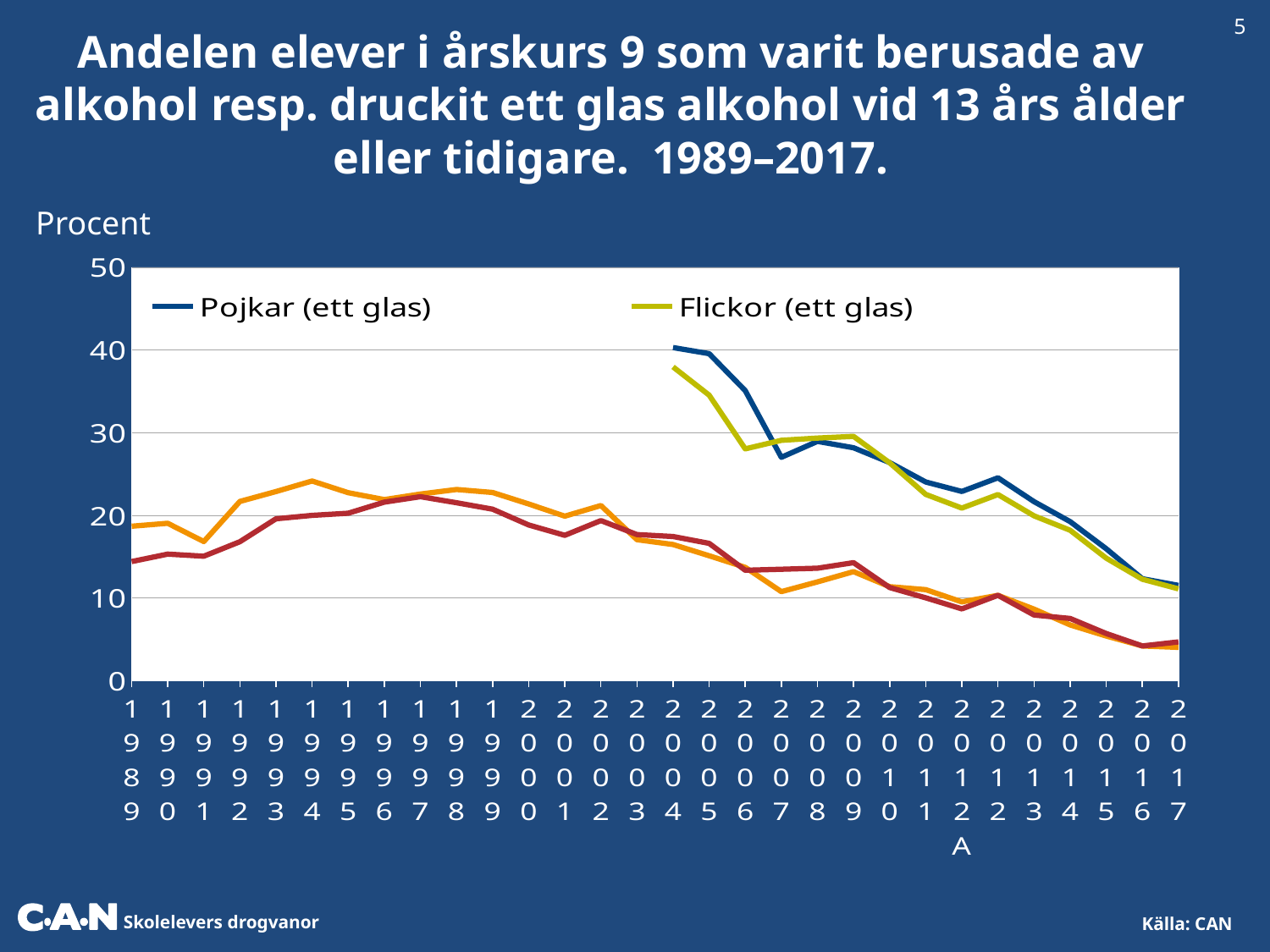
What kind of chart is shown on the slide? line chart What label is shown above the y axis of the chart? Procent Is the value for Pojkar (ett glas) in 2017 greater or less than 20? less Does the Pojkar (ett glas) series generally rise or fall from 2004 to 2017? fall Is the value for Flickor (ett glas) in 2006 greater or less than 30? less Is the value for Pojkar (ett glas) in 2012 greater or less than 20? greater Which two series are named in the chart's legend? Pojkar (ett glas) and Flickor (ett glas) In which year does the Pojkar (ett glas) series reach its highest value? 2004 How many series does the chart's legend list? 2 In 2006, which series has the larger value: Pojkar (ett glas) or Flickor (ett glas)? Pojkar (ett glas)